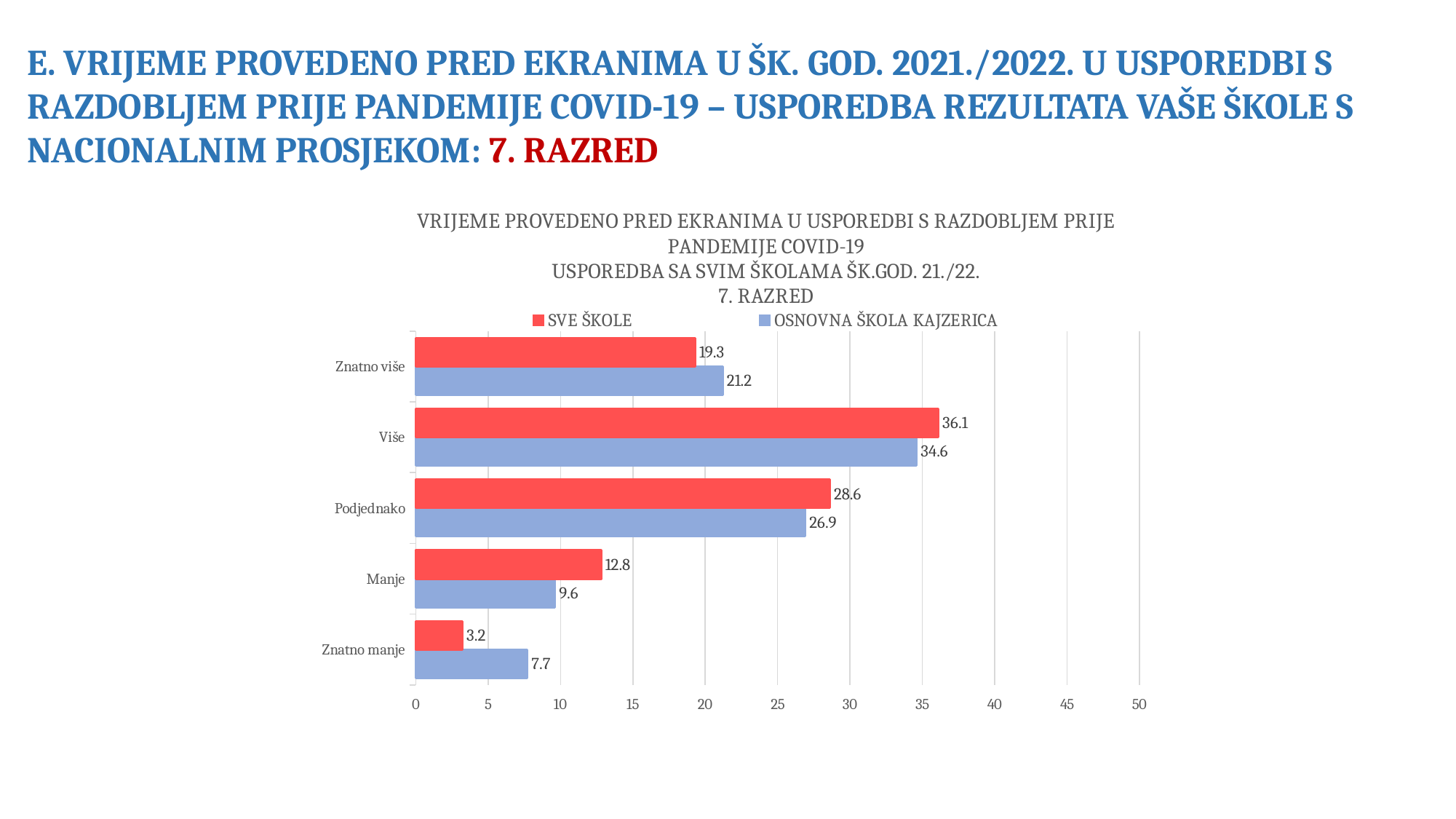
What is the value for SVE ŠKOLE in the Više category? 36.1 Is the value for SVE ŠKOLE in the Podjednako category greater or less than 25? greater What kind of chart is shown on the slide? bar chart How many categories are shown on the chart? 5 What is the value for OSNOVNA ŠKOLA KAJZERICA in the Znatno manje category? 7.7 Which colour represents the SVE ŠKOLE series? red In the Znatno više category, which series has the larger value, SVE ŠKOLE or OSNOVNA ŠKOLA KAJZERICA? OSNOVNA ŠKOLA KAJZERICA How many series does the legend list? 2 Which category has the lowest value for SVE ŠKOLE? Znatno manje What is the value for OSNOVNA ŠKOLA KAJZERICA in the Podjednako category? 26.9 Which category has the highest value for OSNOVNA ŠKOLA KAJZERICA? Više What is the difference between the SVE ŠKOLE and OSNOVNA ŠKOLA KAJZERICA values in the Manje category? 3.2